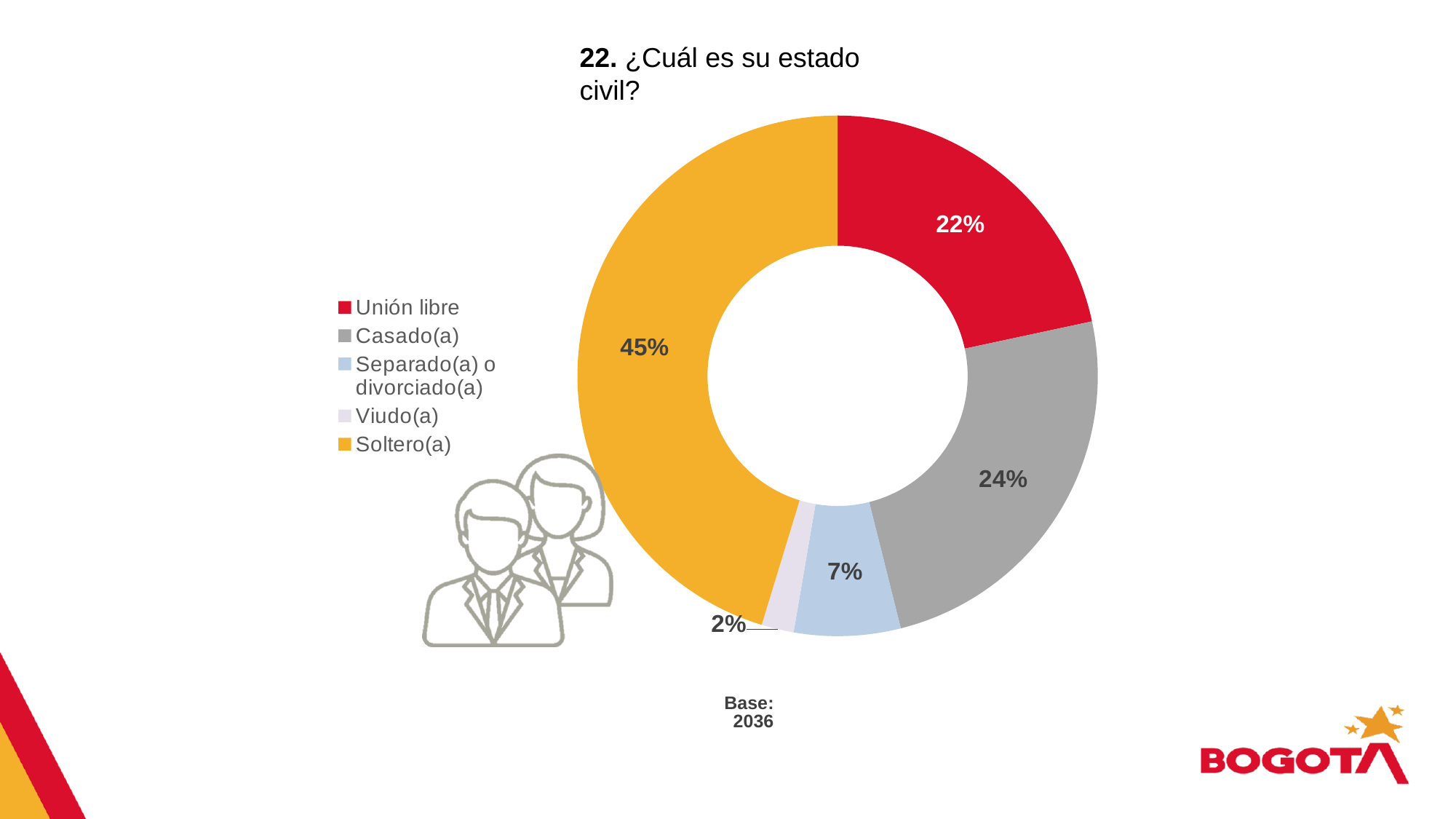
What percentage of respondents are in Unión libre? 22% What percentage of respondents are Soltero(a)? 45% How many categories does the chart show? 5 What percentage of respondents are Casado(a)? 24% What is the difference in percentage points between Soltero(a) and Casado(a)? 21 What kind of chart is shown on the slide? Pie chart (doughnut) What is the base (number of respondents) shown below the chart? 2036 What percentage of respondents are Separado(a) o divorciado(a)? 7% Which marital status has the largest share? Soltero(a) What percentage of respondents are Viudo(a)? 2% Which is larger, the share for Casado(a) or the share for Unión libre? Casado(a) Which marital status has the smallest share? Viudo(a)